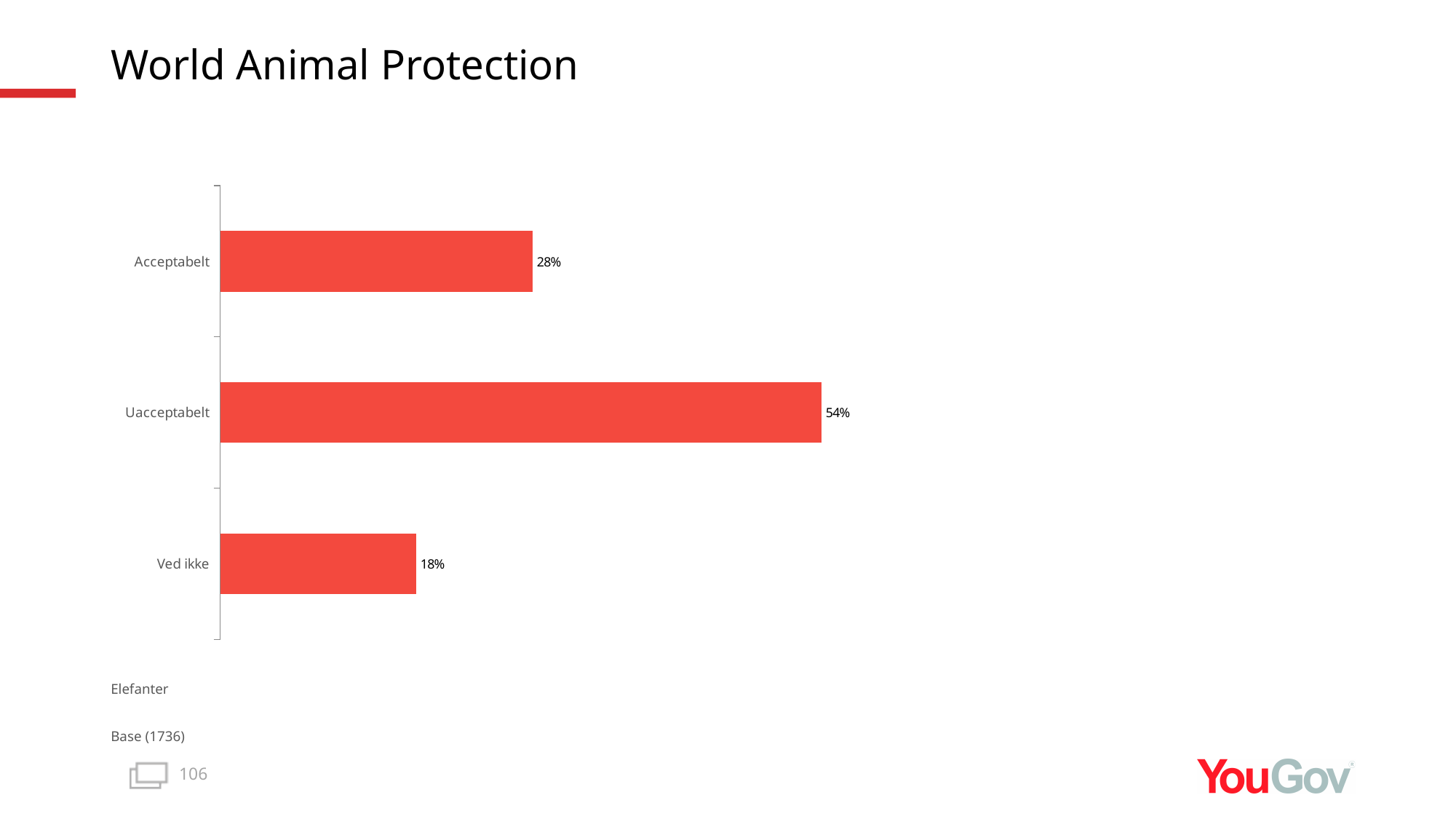
Which category has the lowest value? Ved ikke What is the title of the slide? World Animal Protection How many categories are shown in the chart? 3 What is the value for Uacceptabelt? 54% What is the difference between Acceptabelt and Ved ikke? 10% What base size is stated below the chart? 1736 What is the value for Ved ikke? 18% What is the difference between Uacceptabelt and Acceptabelt? 26% Which category has the highest value? Uacceptabelt What is the value for Acceptabelt? 28% What kind of chart is shown on the slide? Bar chart Which is larger, Acceptabelt or Ved ikke? Acceptabelt